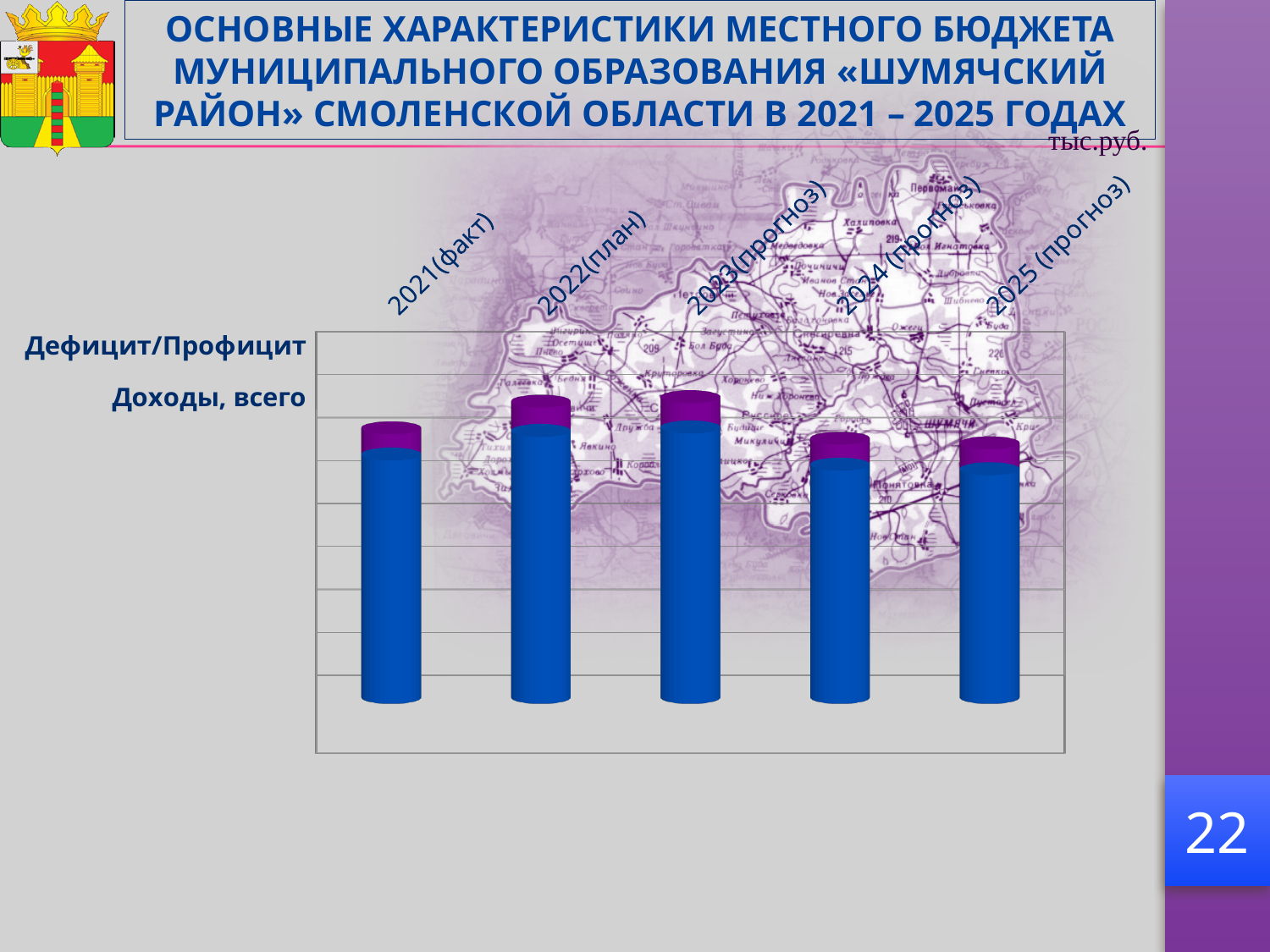
What unit is indicated for the chart's values? тыс.руб. Which is taller, the bar for 2022(план) or the bar for 2024 (прогноз)? 2022(план) Which category label is shown for the last bar on the chart? 2025 (прогноз) Do the bars rise or fall from 2021(факт) to 2022(план)? rise Which category label is shown for the first bar on the chart? 2021(факт) What kind of chart is shown on the slide? bar chart Do the bars rise or fall from 2023(прогноз) to 2024 (прогноз)? fall How many categories (years) are plotted on the chart? 5 Which is taller, the bar for 2021(факт) or the bar for 2023(прогноз)? 2023(прогноз)